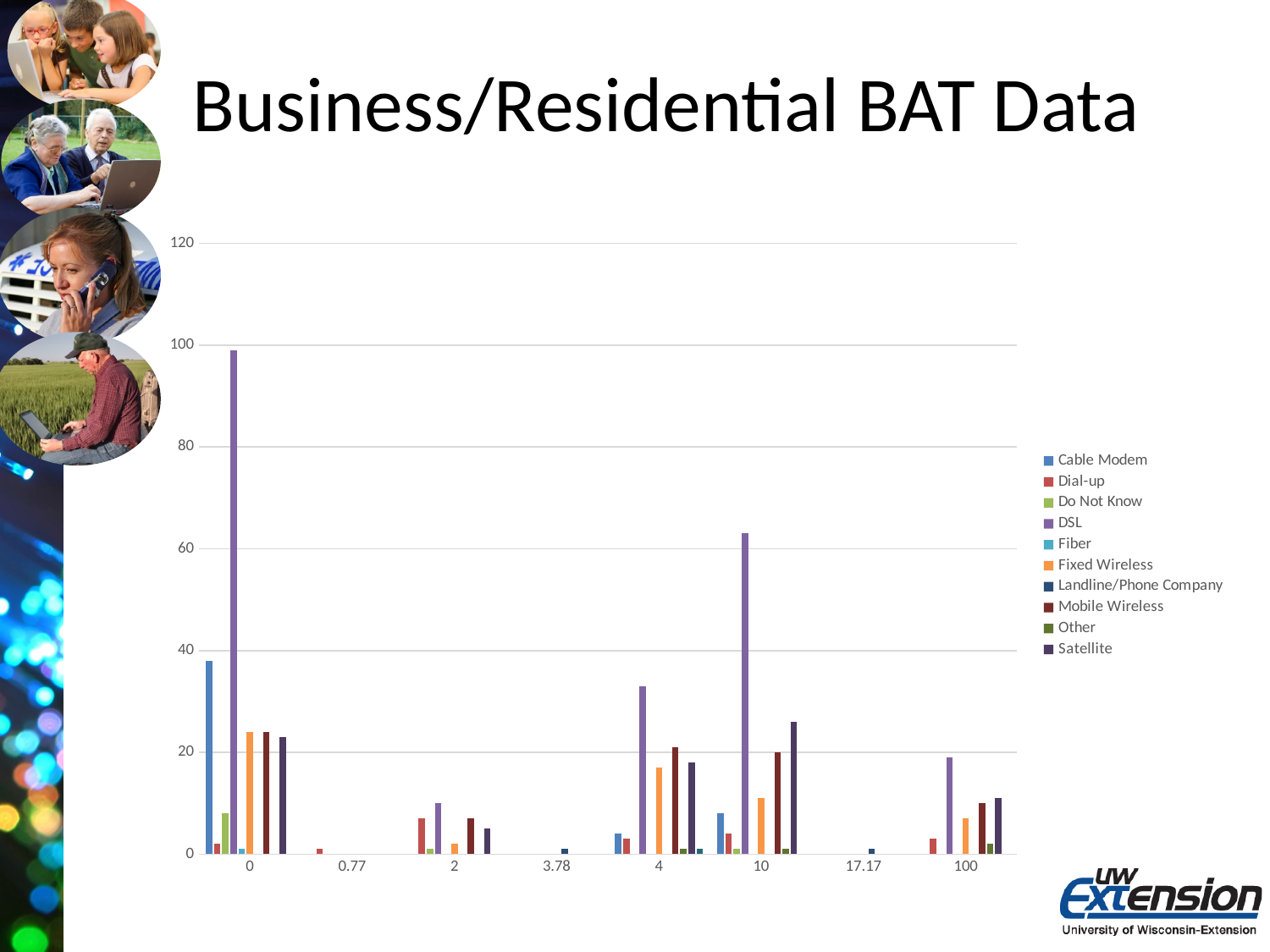
What is the title of the chart? Business/Residential BAT Data Which is larger: the Cable Modem value in the 0 category or the Cable Modem value in the 10 category? 0 category How many categories are shown along the x axis? 8 How many series does the legend list? 10 Is the DSL value in the 4 category greater or less than 40? less Which series has the tallest bar in the 0 category? DSL Which series has the tallest bar in the 10 category? DSL Is the DSL value in the 0 category greater or less than 80? greater What kind of chart is shown on the slide? bar chart In which category does the DSL series reach its highest value? 0 Is the DSL value in the 10 category greater or less than 40? greater Which legend entry is listed last? Satellite